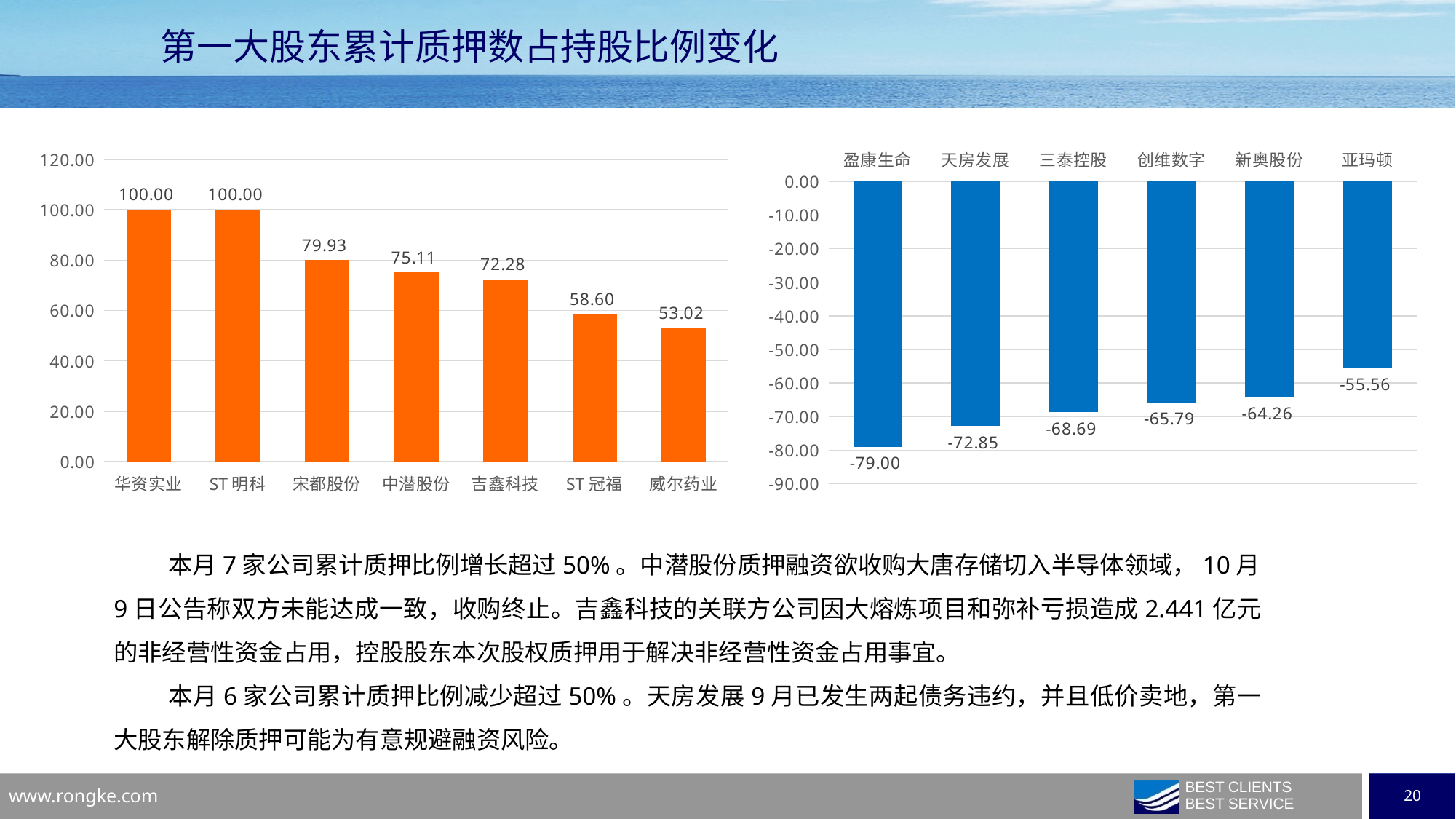
In the right chart, what is the value for 亚玛顿? -55.56 How many categories are shown in the left chart? 7 In the left chart, what is the value for ST 冠福? 58.60 In the right chart, what is the value for 天房发展? -72.85 In the right chart, do the values rise or fall from left to right along the x axis? rise In the left chart, what is the value for 宋都股份? 79.93 In the right chart, what is the difference between the values for 亚玛顿 and 盈康生命? 23.44 In the left chart, what is the difference between the values for 宋都股份 and 中潜股份? 4.82 In the right chart, which category has the highest value? 亚玛顿 In the left chart, which category has the lowest value? 威尔药业 In the right chart, which category has the lowest value? 盈康生命 In the left chart, which is larger, the value for 吉鑫科技 or the value for ST 冠福? 吉鑫科技